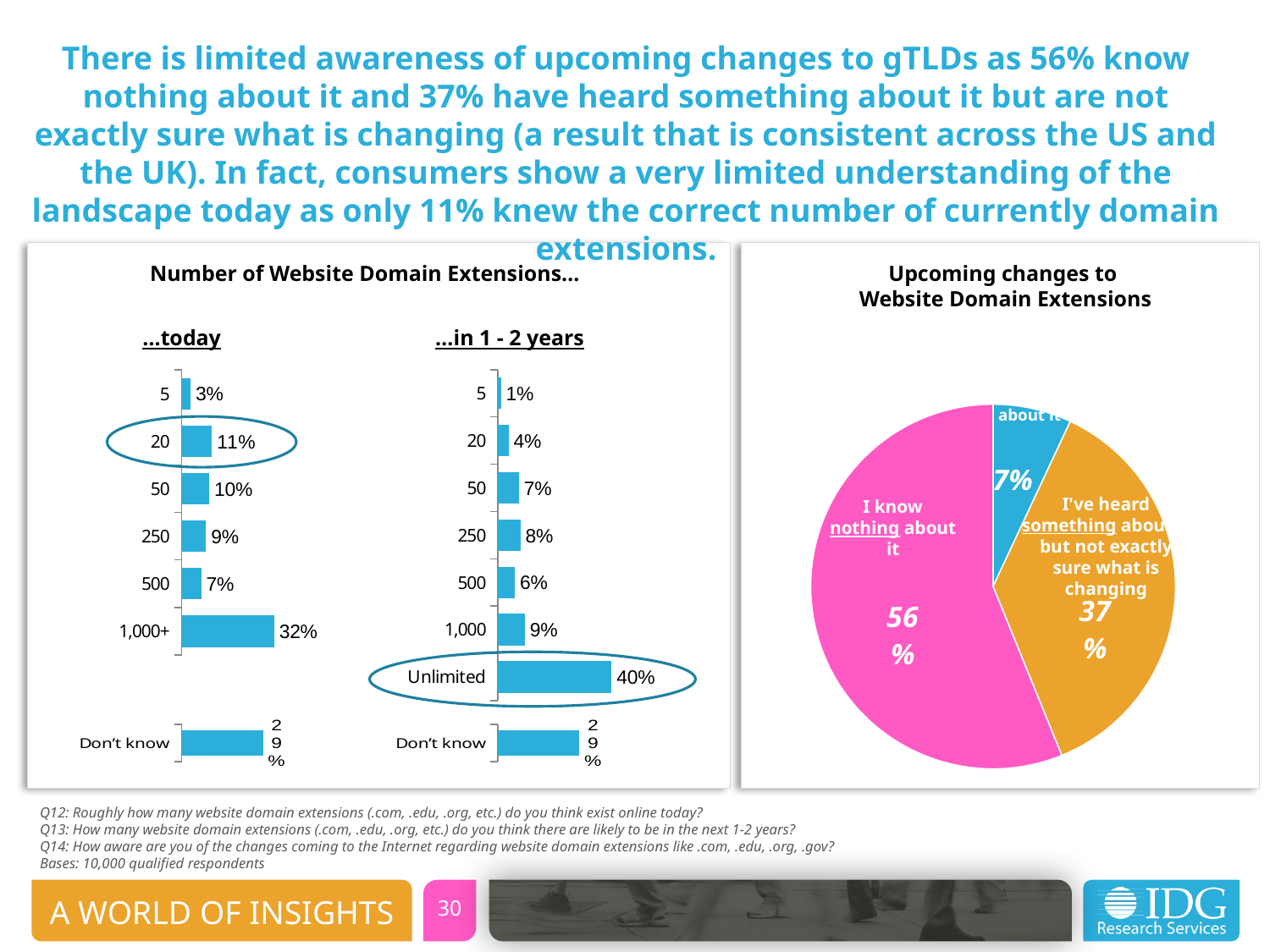
In the "...today" bar chart, what percentage of respondents said 20 domain extensions exist today? 11% What type of chart is the "Upcoming changes to Website Domain Extensions" chart? Pie chart In the "...in 1 - 2 years" bar chart, what percentage of respondents said there will be an Unlimited number of domain extensions? 40% In the "...today" bar chart, which category has the highest value? 1,000+ What type of chart is the "...today" chart? Bar chart In the "...today" bar chart, what is the difference between the values for 1,000+ and 20? 21% In the "Upcoming changes to Website Domain Extensions" pie chart, what is the difference between the "I know nothing about it" slice and the "I've heard something about it but not exactly sure what is changing" slice? 19% In the "...in 1 - 2 years" bar chart, which is larger: the value for 250 or the value for 500? 250 In the "Upcoming changes to Website Domain Extensions" pie chart, what share of respondents said they know nothing about it? 56% In the "...in 1 - 2 years" bar chart, which category has the lowest value? 5 How many categories are shown in the "...in 1 - 2 years" bar chart? 8 In the "...today" bar chart, what percentage of respondents said 1,000+ domain extensions exist today? 32%